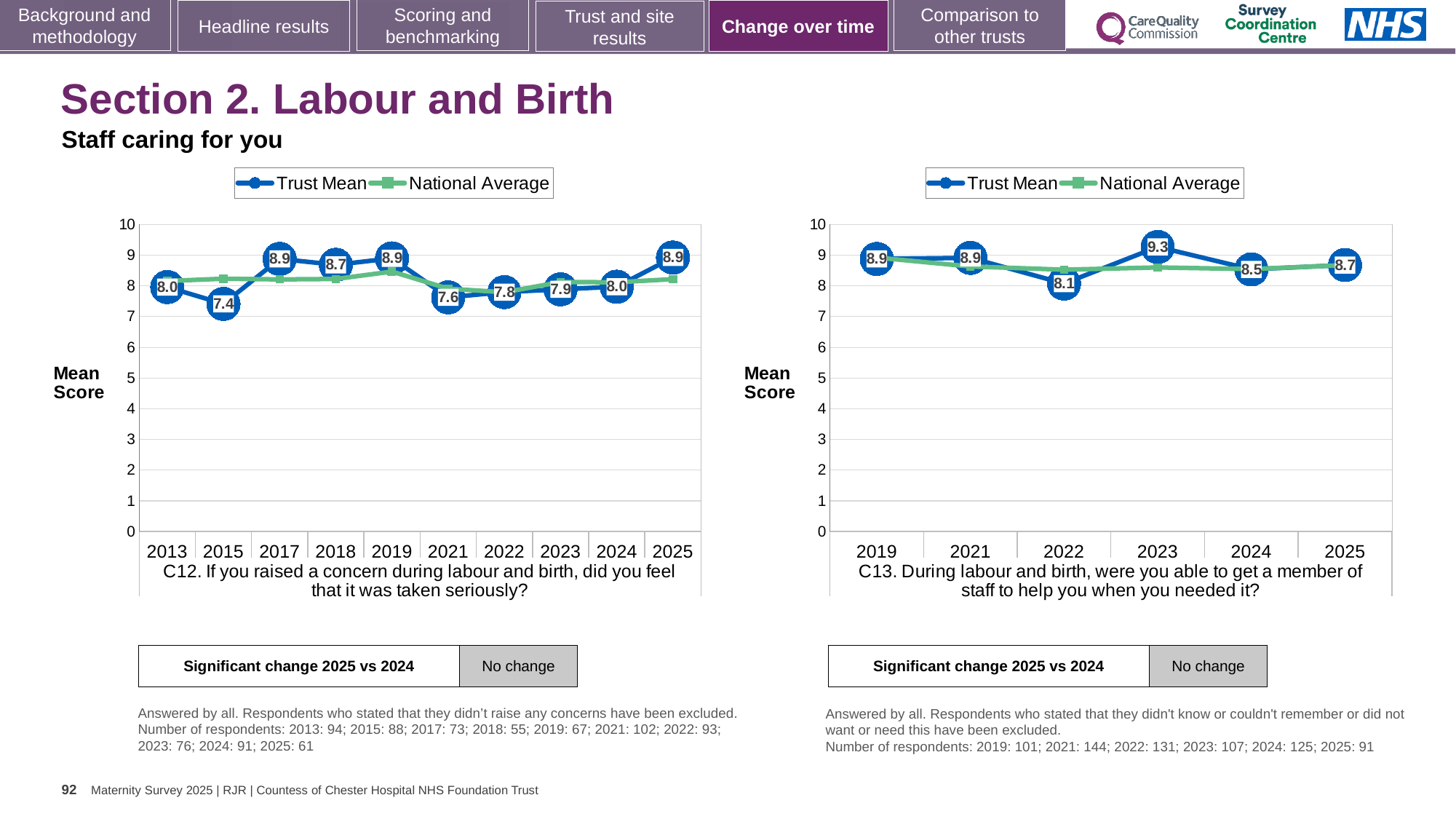
How many series does the legend of the right chart (C13) list? 2 In the right chart (C13), which year has the lowest Trust Mean score? 2022 In the left chart (C12), what is the difference between the Trust Mean scores for 2025 and 2024? 0.9 What kind of chart is the left chart (C12)? Line chart In the right chart (C13), is the National Average value for 2025 greater or less than 8? greater In the right chart (C13), what is the Trust Mean score for 2023? 9.3 In the left chart (C12), which year has the lowest Trust Mean score? 2015 In the right chart (C13), which year has the highest Trust Mean score? 2023 How many years are plotted on the x axis of the left chart (C12)? 10 In the left chart (C12), what is the Trust Mean score for 2015? 7.4 In the right chart (C13), what is the difference between the Trust Mean scores for 2023 and 2022? 1.2 In the left chart (C12), which year has the higher Trust Mean score, 2015 or 2021? 2021